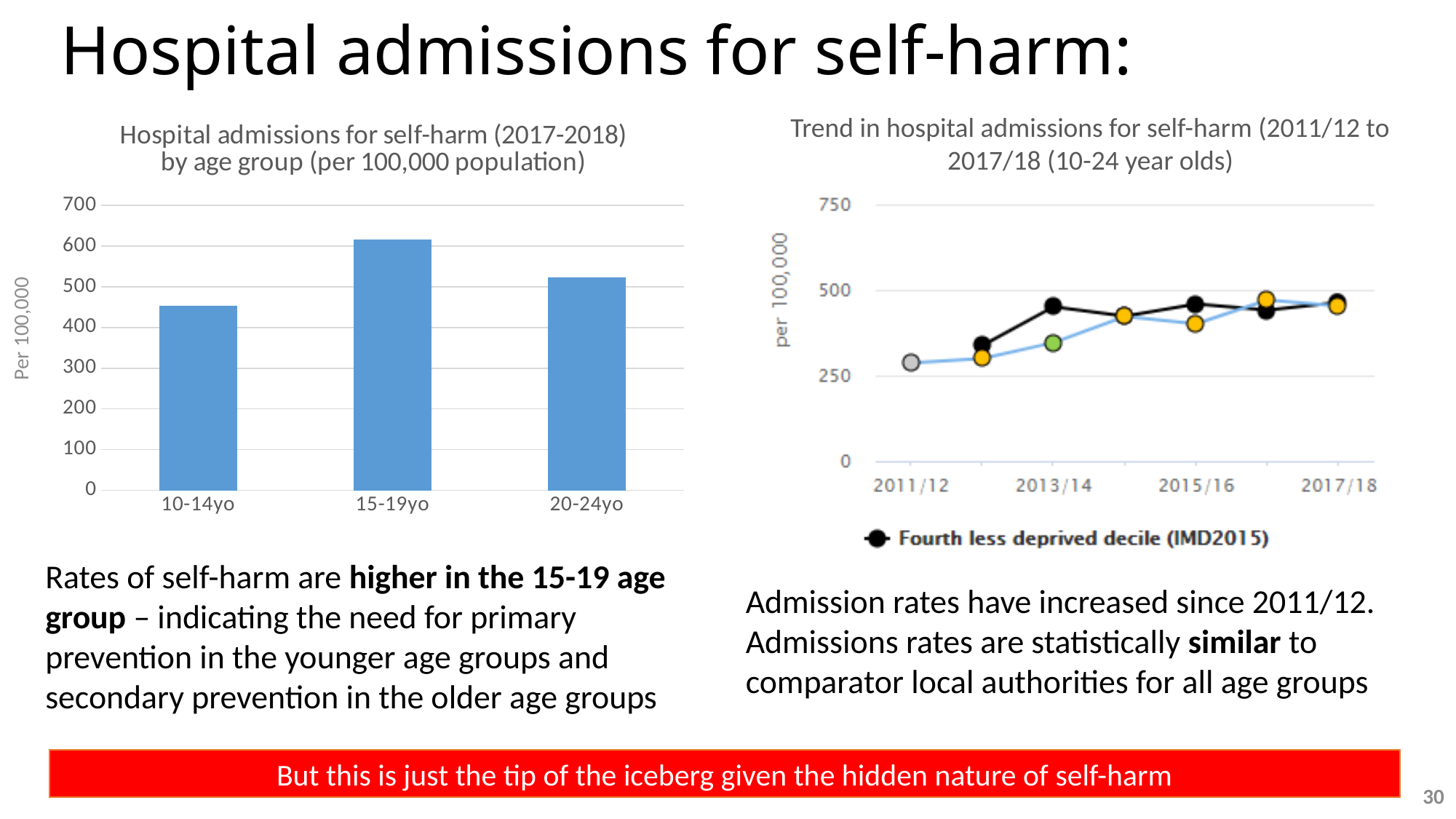
In the right chart, do admission rates generally rise or fall from 2011/12 to 2017/18? Rise In the left chart, is the value for 10-14yo greater or less than 500? less In the left chart, how many age groups are plotted? 3 In the left chart, is the value for 15-19yo greater or less than 600? greater In the left chart, is the value for 20-24yo greater or less than 500? greater In the left chart, which age group has the lowest rate of hospital admissions for self-harm? 10-14yo In the right chart, what series name is shown in the legend? Fourth less deprived decile (IMD2015) In the right chart, 'Trend in hospital admissions for self-harm', what kind of chart is shown? Line chart In the left chart, 'Hospital admissions for self-harm (2017-2018) by age group', what kind of chart is shown? Bar chart In the left chart, which age group has the highest rate of hospital admissions for self-harm? 15-19yo In the left chart, which has the higher admission rate: 20-24yo or 10-14yo? 20-24yo In the left chart, what is the label on the vertical axis? Per 100,000